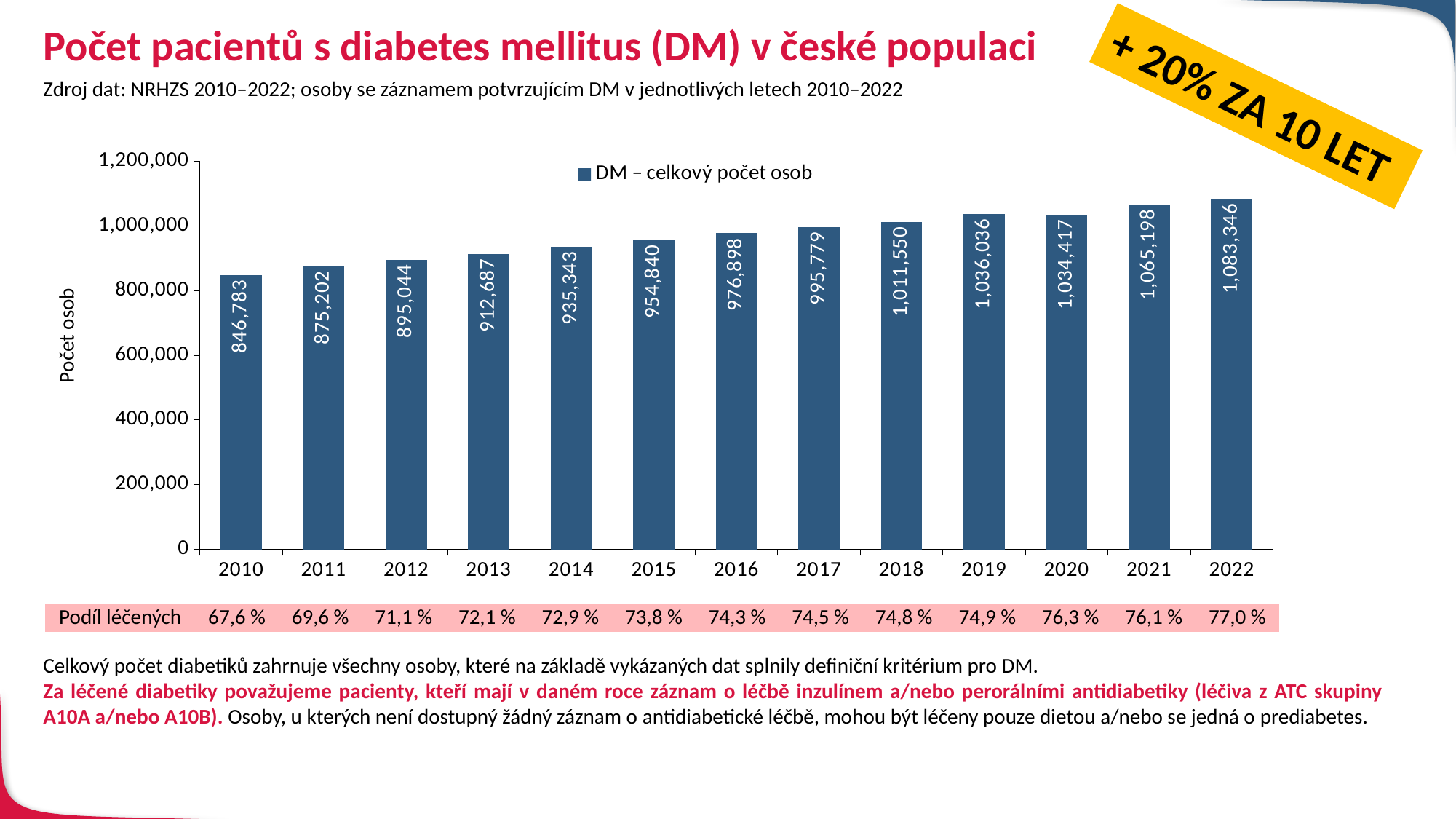
Which is larger, the value for 2015 or the value for 2018? 2018 What kind of chart is shown? bar chart Is the value for 2014 greater or less than 1,000,000? less What is the difference between the values for 2022 and 2010? 236,563 How many series does the legend list? 1 How many years are shown on the x axis? 13 What is the value for 2010? 846,783 What is the value for 2022? 1,083,346 What is the value for 2016? 976,898 Which year has the highest value? 2022 Do the values generally rise or fall from 2010 to 2022? rise Which year has the lowest value? 2010